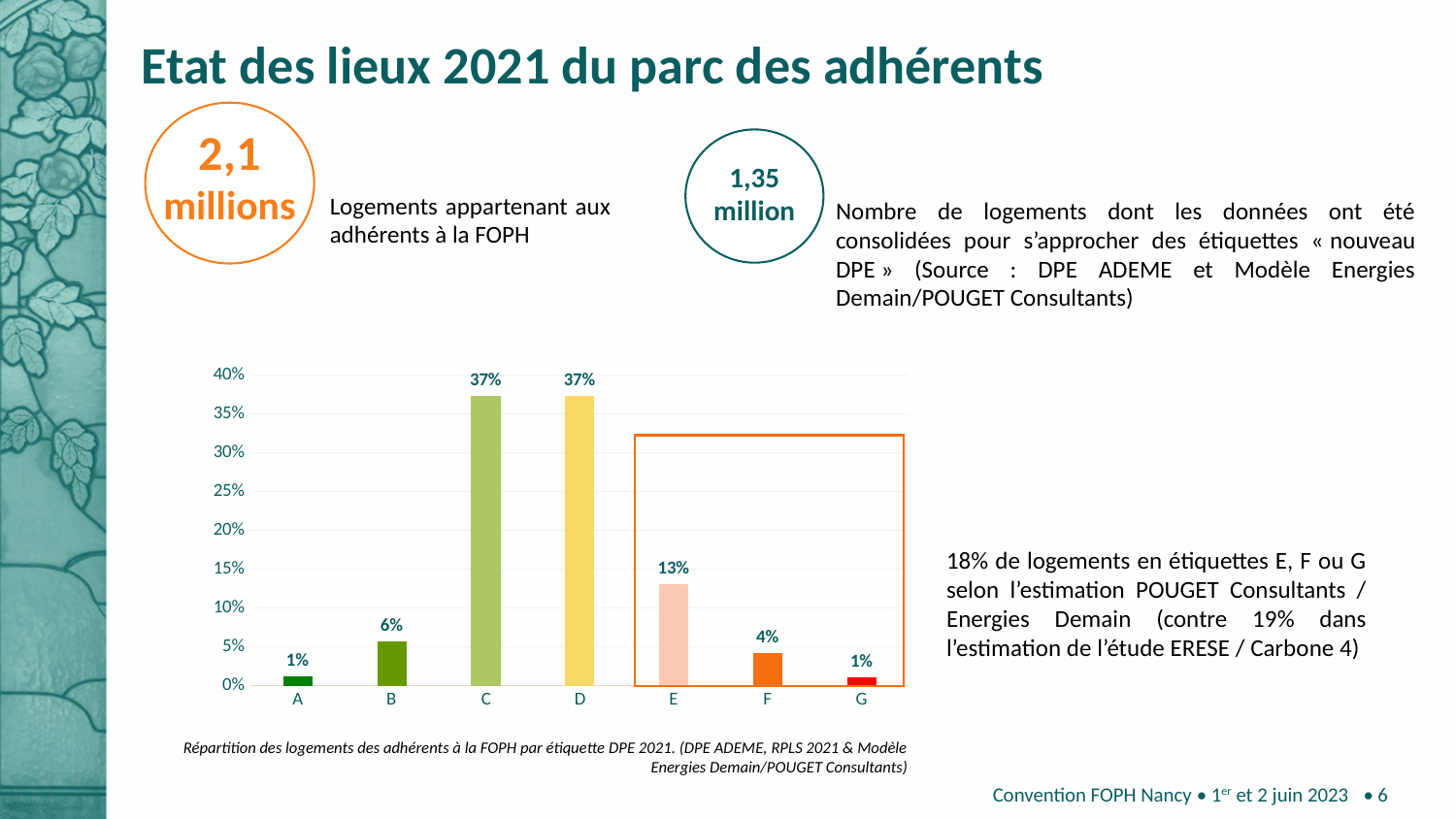
Which is larger in the bar chart, the value for B or the value for C? C Is the value for D in the bar chart greater or less than 35%? greater What type of chart is shown on the slide? bar chart What is the value for category C in the bar chart? 37% Which is larger in the bar chart, the value for E or the value for F? E What is the total of the values for E, F and G in the bar chart? 18% What is the difference between the values for E and F in the bar chart? 9% How many categories are shown on the x axis of the bar chart? 7 What is the value for category E in the bar chart? 13% Which categories in the bar chart are enclosed by the orange outlined box? E, F and G What is the value for category F in the bar chart? 4% What is the value for category B in the bar chart? 6%